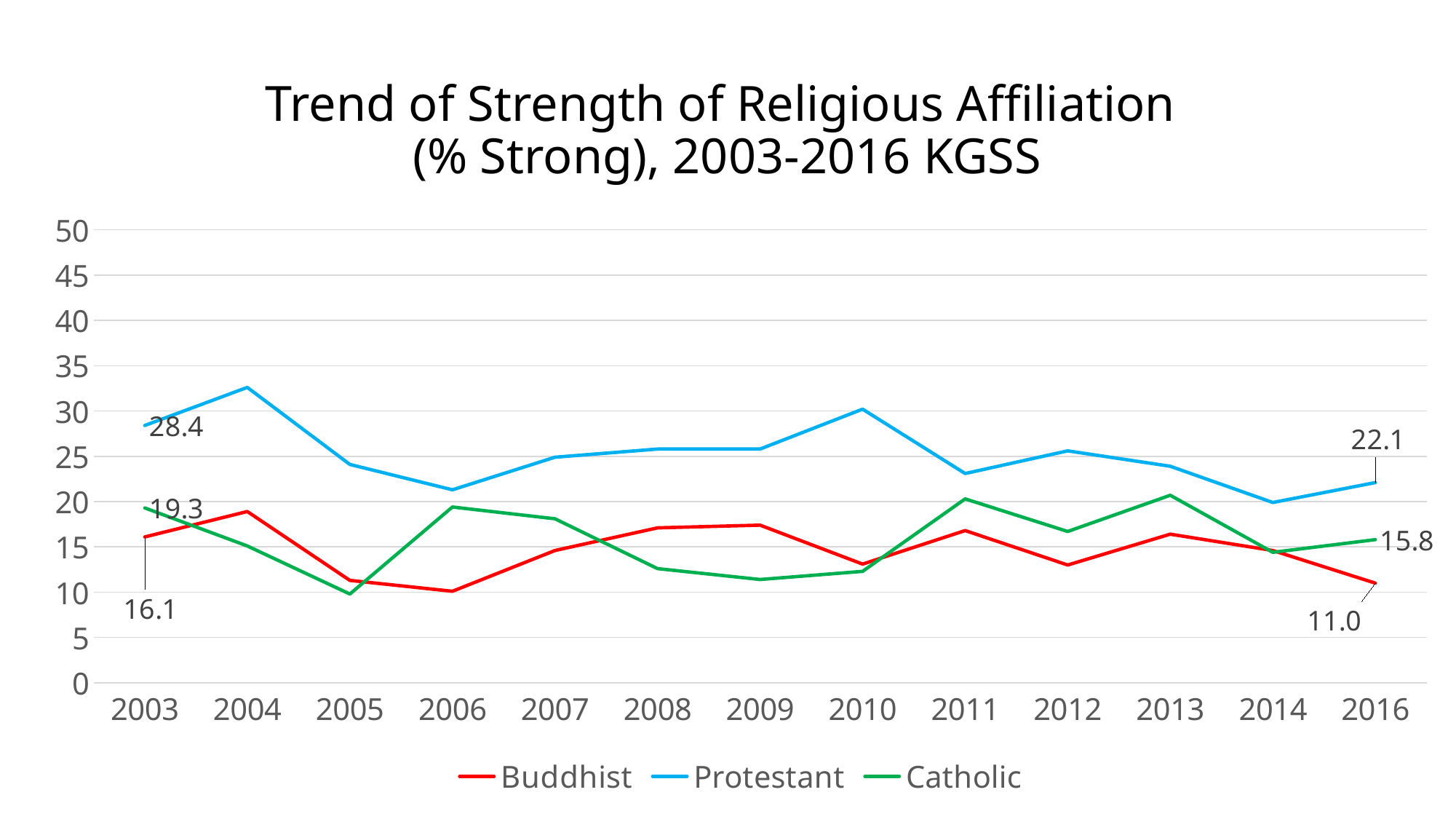
What is the difference between the Protestant value in 2003 and in 2016? 6.3 What is the value for Protestant in 2003? 28.4 How many series does the legend list? 3 What kind of chart is shown on the slide? line chart Is the value for Protestant in 2004 greater or less than 30? greater Which series has the highest value in 2003? Protestant What is the value for Buddhist in 2016? 11.0 Is the value for Catholic in 2005 greater or less than 15? less In 2016, which is larger: the Catholic value or the Buddhist value? Catholic How many years are plotted on the x axis? 13 By how much did the Buddhist value fall from 2003 to 2016? 5.1 What is the value for Catholic in 2003? 19.3